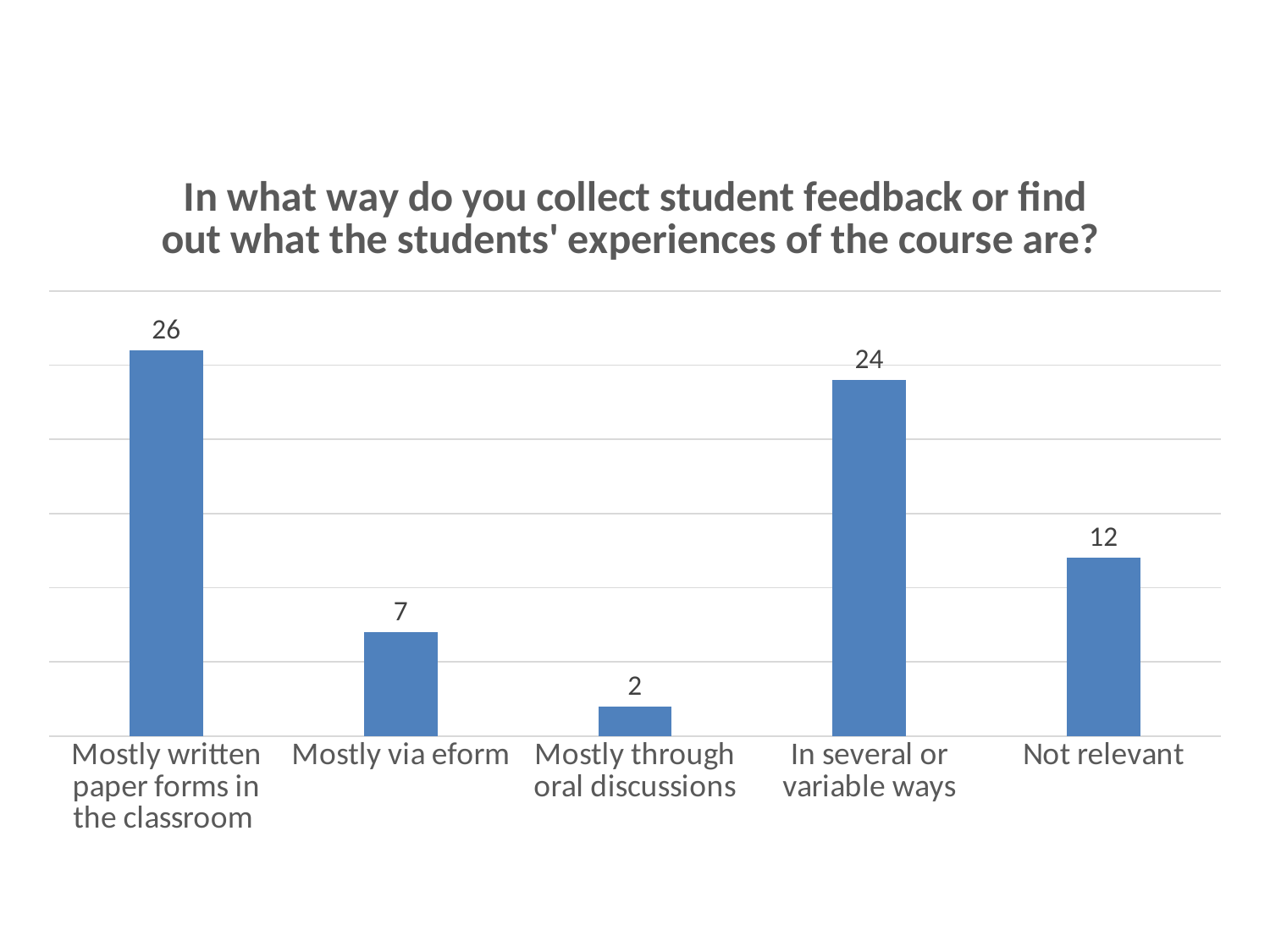
What is the value for "Not relevant"? 12 What is the difference between the values for "Mostly written paper forms in the classroom" and "In several or variable ways"? 2 Which category has the highest value? Mostly written paper forms in the classroom How many categories are shown in the chart? 5 What is the value for "Mostly via eform"? 7 Which is larger, the value for "Not relevant" or the value for "Mostly via eform"? Not relevant What is the title of the chart? In what way do you collect student feedback or find out what the students' experiences of the course are? Which category has the lowest value? Mostly through oral discussions What is the value for "In several or variable ways"? 24 What kind of chart is shown on the slide? Bar chart What is the value for "Mostly through oral discussions"? 2 What is the value for "Mostly written paper forms in the classroom"? 26